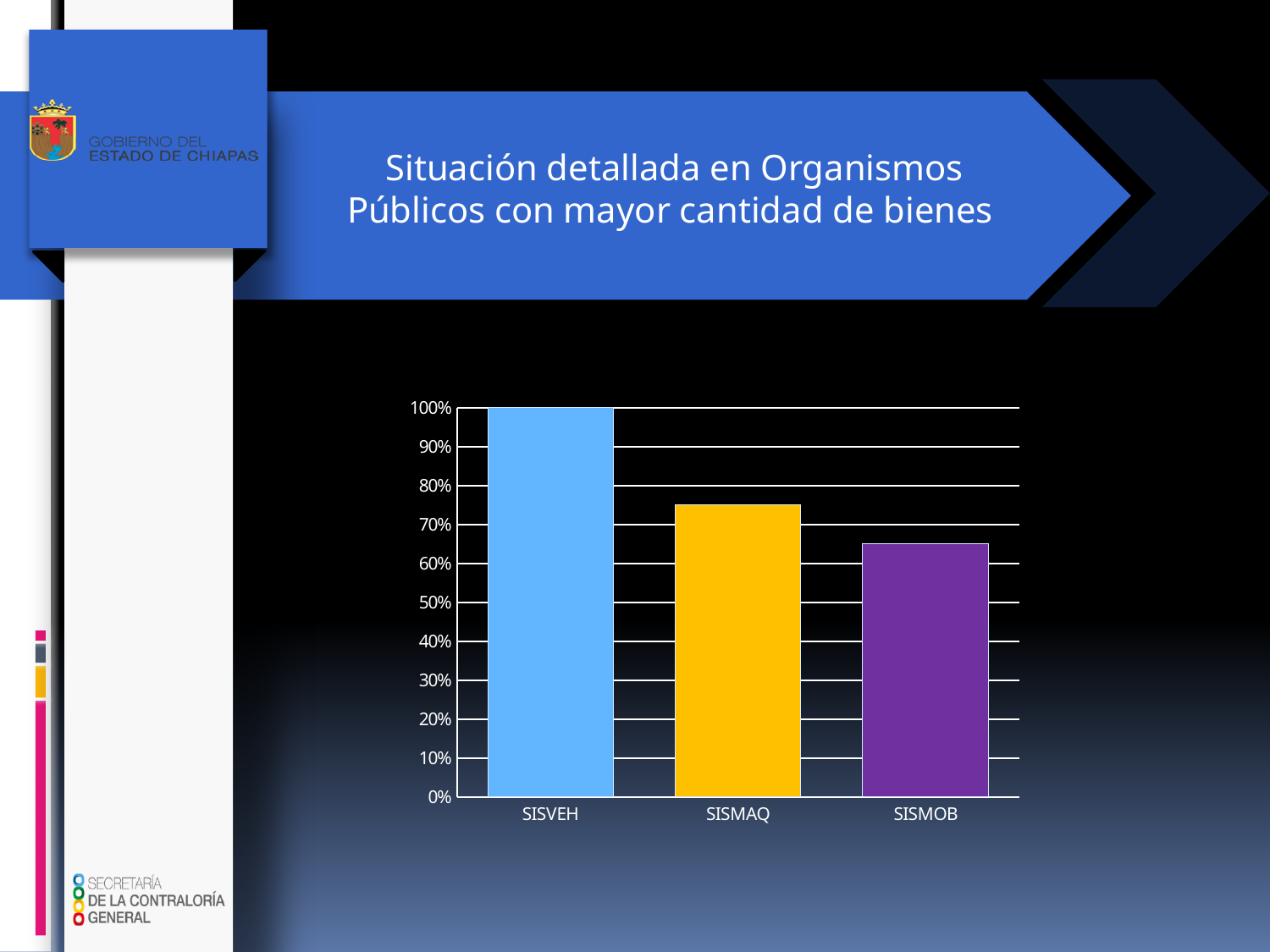
What kind of chart is shown on the slide? bar chart How many categories are plotted on the chart? 3 Is the value for SISMAQ greater or less than 70%? greater Is the value for SISMOB greater or less than 60%? greater What is the value for SISVEH? 100% What colour is the bar for SISMAQ? yellow Is the value for SISMAQ greater or less than 80%? less Do the values rise or fall from left to right along the x axis? fall Which category has the highest value? SISVEH Which category has the lowest value? SISMOB Which is larger, the value for SISMAQ or the value for SISMOB? SISMAQ